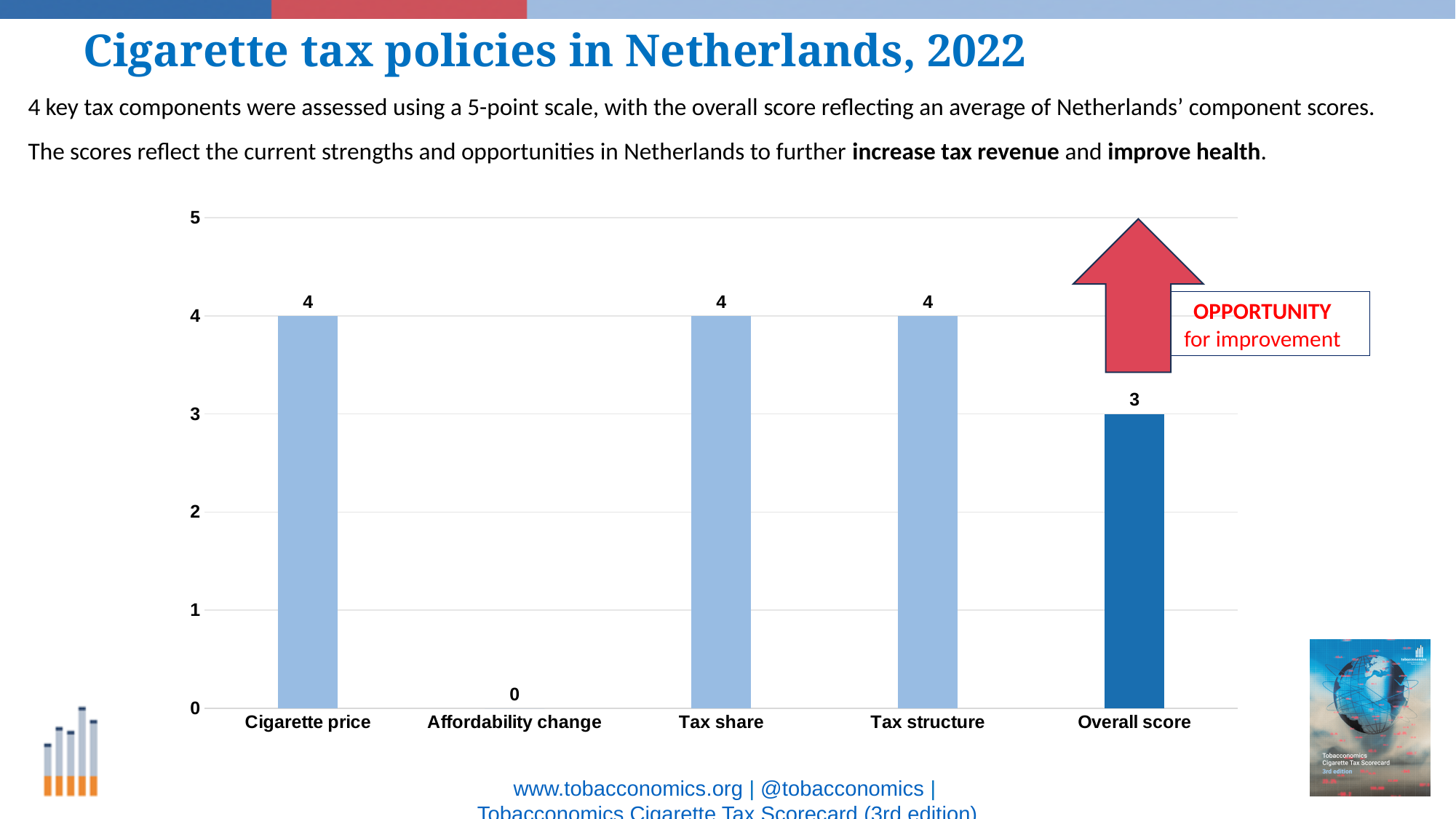
Which category has the lowest score? Affordability change What is the score for Tax share? 4 What is the score for Cigarette price? 4 What kind of chart is shown on the slide? Bar chart What is the maximum value shown on the y axis? 5 What is the Overall score? 3 How many categories are shown on the x axis? 5 What is the score for Affordability change? 0 What is the score for Tax structure? 4 What is the difference between the Tax share score and the Overall score? 1 Which is larger, the score for Tax structure or the Overall score? Tax structure What is the difference between the Cigarette price score and the Affordability change score? 4